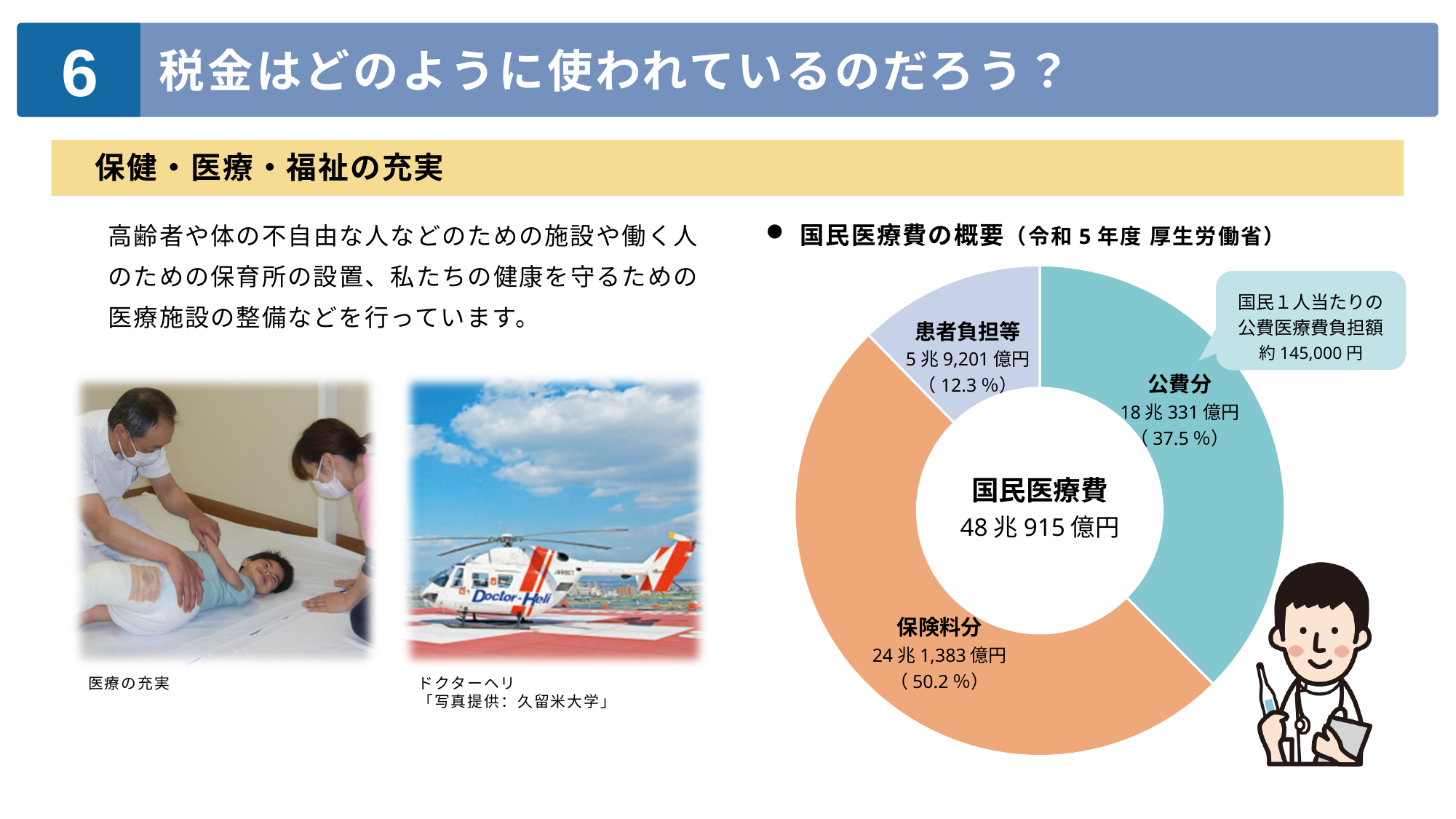
What is the value of the 保険料分 slice? 24兆1,383億円 Which is larger, 公費分 or 患者負担等? 公費分 Which slice of the pie chart is the largest? 保険料分 What kind of chart is shown on the slide? Pie chart (donut) What is the value of the 患者負担等 slice? 5兆9,201億円 What is the value of the 公費分 slice? 18兆331億円 What is the total 国民医療費 shown in the centre of the chart? 48兆915億円 Which slice of the pie chart is the smallest? 患者負担等 By how many percentage points does the 保険料分 share exceed the 公費分 share? 12.7 percentage points How many slices does the 国民医療費 pie chart have? 3 What share of 国民医療費 does 患者負担等 account for? 12.3% What share of 国民医療費 does 保険料分 account for? 50.2%